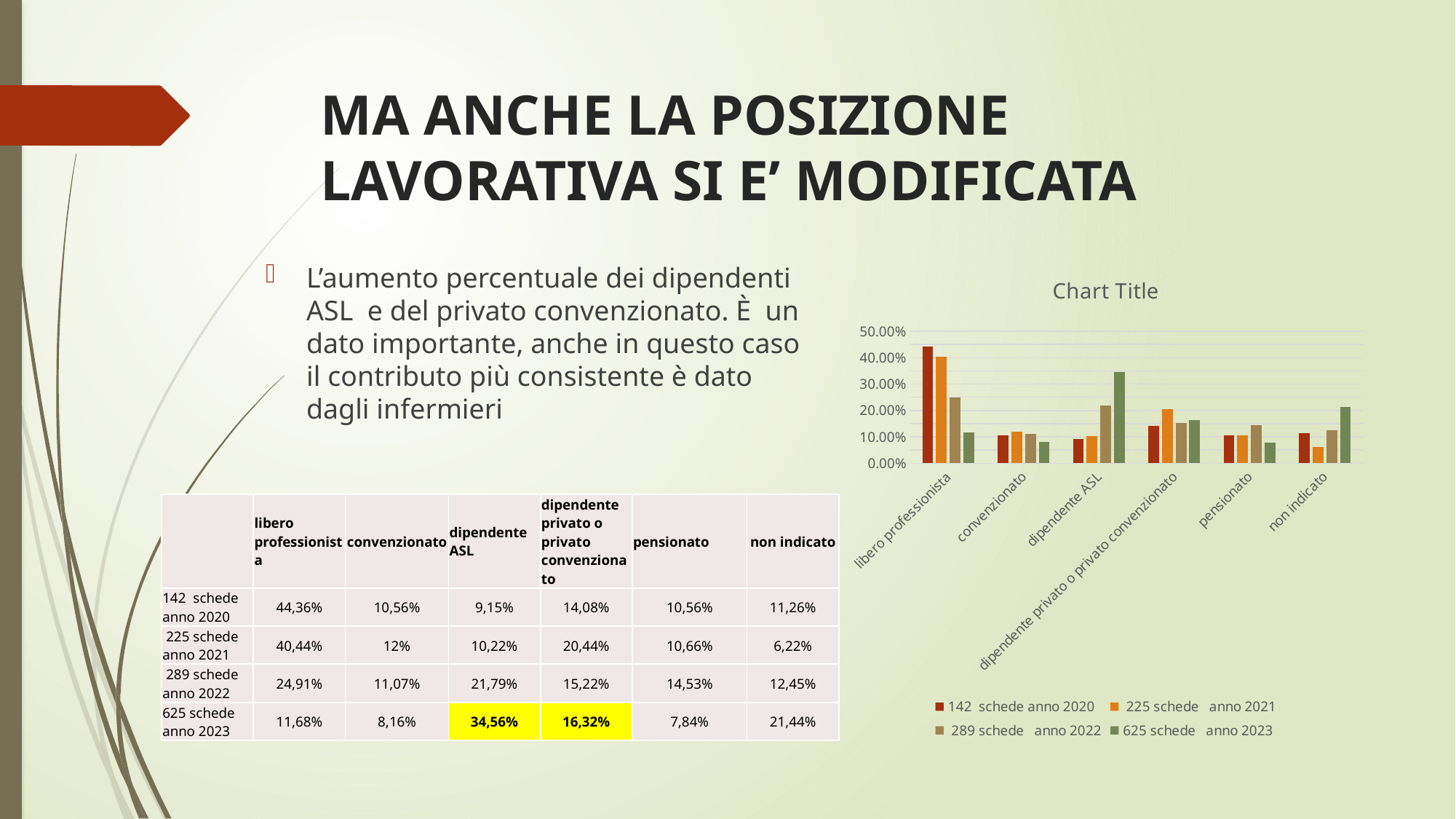
According to the table on the slide, what is the value for 'dipendente privato o privato convenzionato' in '225 schede anno 2021'? 20,44% Is the value for 'convenzionato' in the series '625 schede anno 2023' greater or less than 10.00%? less How many categories are shown on the x axis of the chart? 6 According to the table on the slide, what is the value for 'dipendente ASL' in '625 schede anno 2023'? 34,56% How many series does the chart legend list? 4 What kind of chart is shown on the slide? bar chart Is the value for 'dipendente ASL' in the series '625 schede anno 2023' greater or less than 30.00%? greater For the category 'libero professionista', which series has the highest bar? 142 schede anno 2020 Using the table values, what is the difference between 'dipendente ASL' in '625 schede anno 2023' (34,56%) and in '289 schede anno 2022' (21,79%)? 12,77% For the category 'non indicato', which is larger: the bar for '289 schede anno 2022' or the bar for '625 schede anno 2023'? 625 schede anno 2023 What is the title shown above the chart? Chart Title For the category 'non indicato', which series has the lowest bar? 225 schede anno 2021